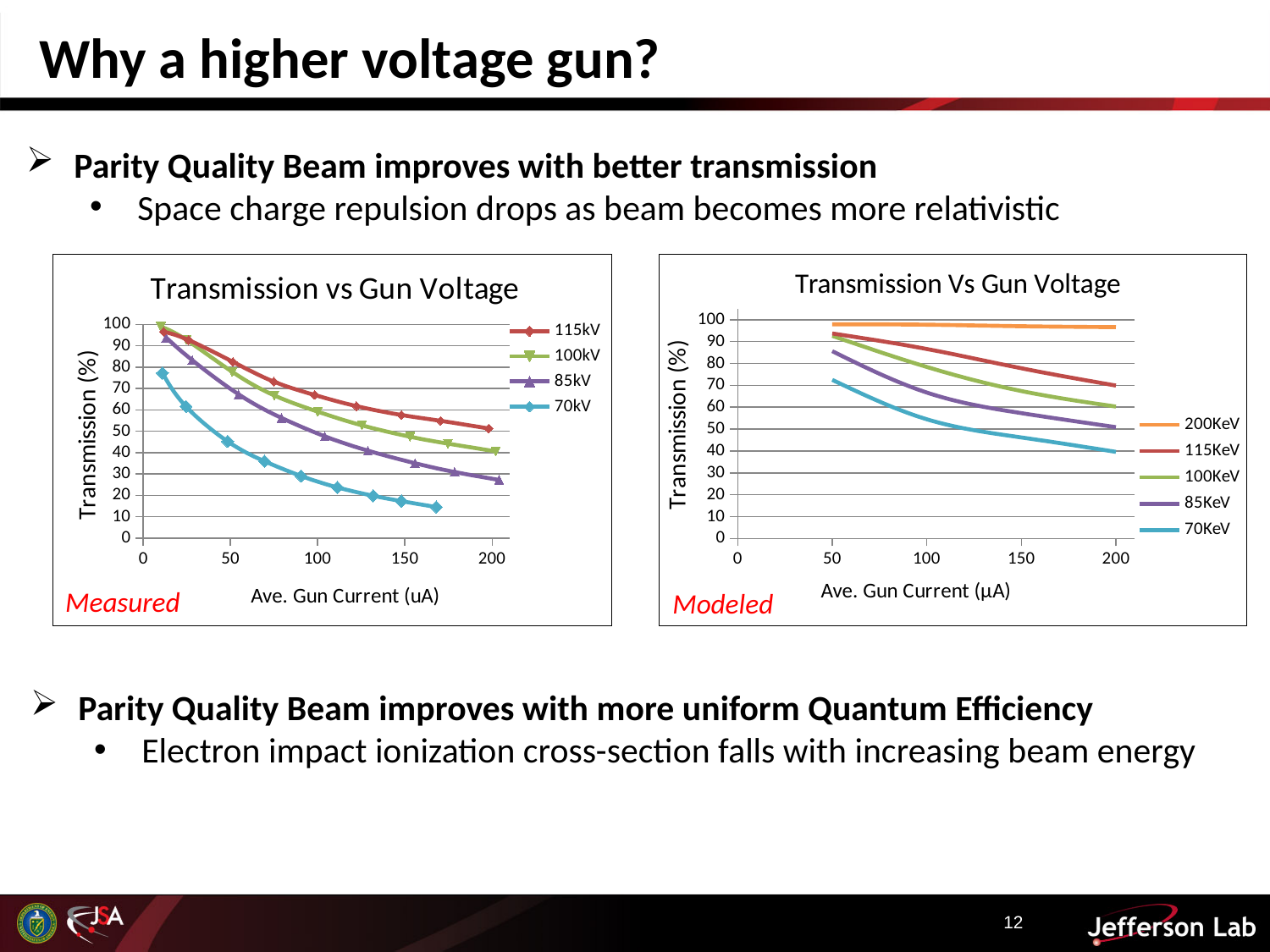
In the right (Modeled) chart, does transmission rise or fall as average gun current increases? fall How many series does the legend of the left (Measured) chart list? 4 How many series does the legend of the right (Modeled) chart list? 5 What is the x-axis label of the left (Measured) chart? Ave. Gun Current (uA) In the right (Modeled) chart, which series has the highest transmission across the plotted currents? 200KeV In the right (Modeled) chart, is the transmission for 70KeV at 50 µA greater or less than 60? greater In the left (Measured) chart, at 100 uA, which series has the higher transmission, 115kV or 70kV? 115kV In the left (Measured) chart, which series has the lowest transmission across the plotted currents? 70kV In the left (Measured) chart, is the transmission for 100kV at 200 uA greater or less than 50? less What kind of chart is the left chart titled 'Transmission vs Gun Voltage' (Measured)? line chart In the left (Measured) chart, does transmission rise or fall as average gun current increases? fall In the right (Modeled) chart, is the transmission for 200KeV at 200 µA greater or less than 90? greater